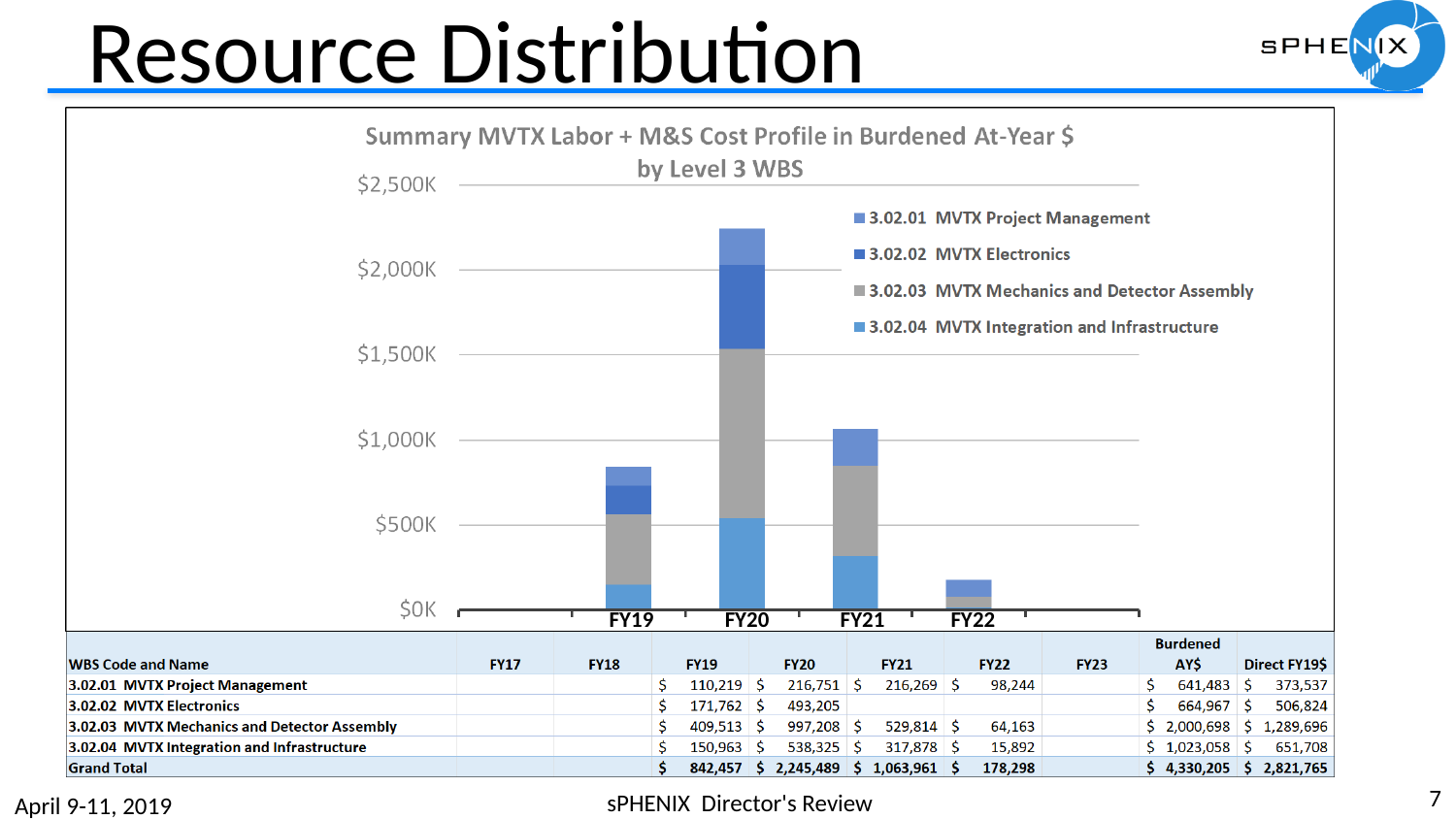
How many fiscal years have bars plotted on the chart's x axis? 4 What kind of chart is shown on the slide? Stacked bar chart Which fiscal year has the larger total stacked bar, FY19 or FY21? FY21 According to the table below the chart, what is the Grand Total for FY20? $2,245,489 According to the table, what is the FY20 value for 3.02.03 MVTX Mechanics and Detector Assembly? $997,208 Using the table values, what is the difference between the Grand Total for FY20 and the Grand Total for FY21? $1,181,528 What is the title of the chart? Summary MVTX Labor + M&S Cost Profile in Burdened At-Year $ by Level 3 WBS How many series does the chart legend list? 4 Which fiscal year has the tallest stacked bar? FY20 Is the total stacked bar for FY19 greater or less than $1,000K? less Is the total stacked bar for FY20 greater or less than $2,000K? greater Which fiscal year has the shortest stacked bar? FY22